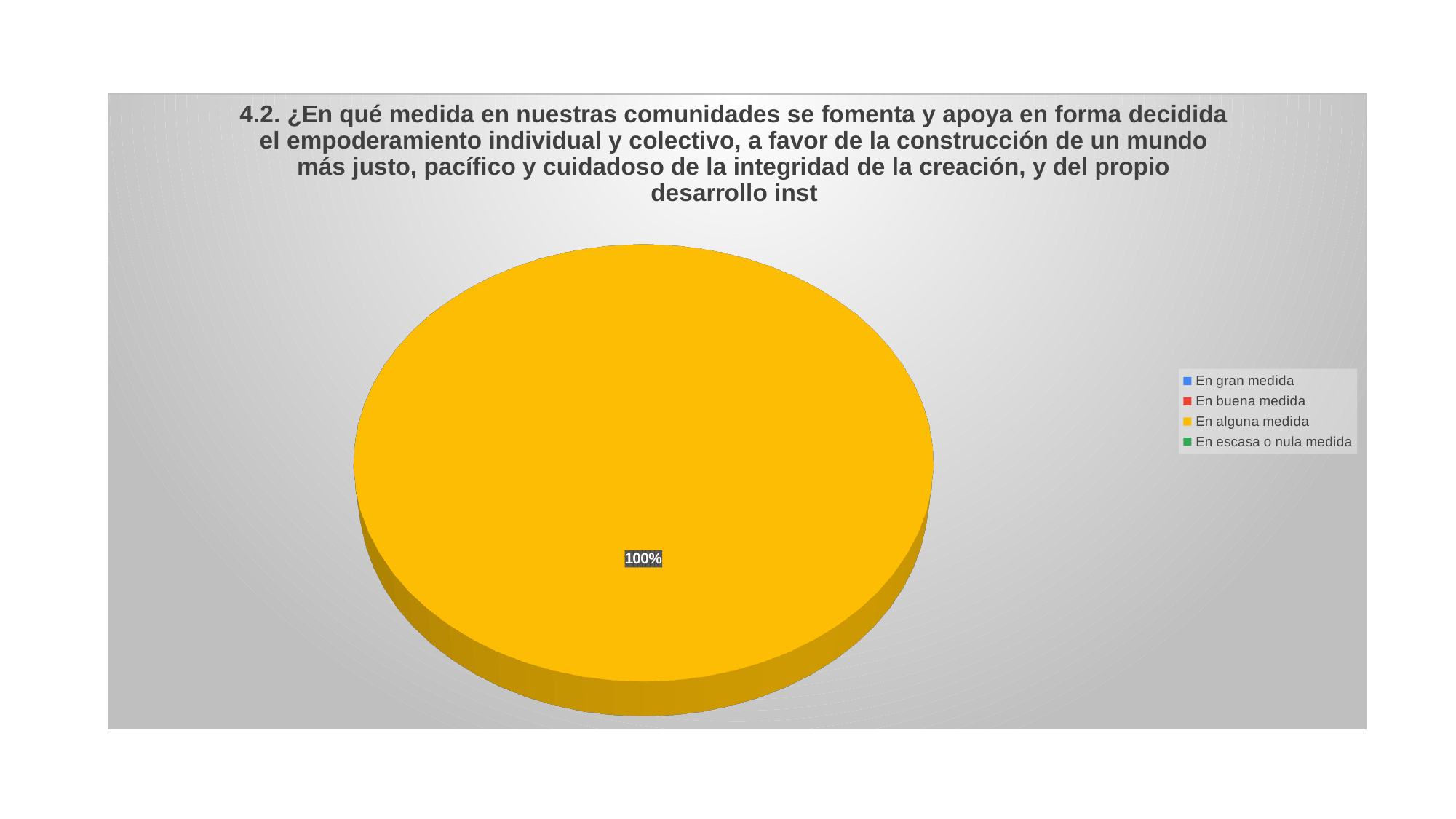
Which legend entry is shown in green? En escasa o nula medida Is the share for "En alguna medida" greater or less than 50%? greater What is the data label printed on the pie slice? 100% Which category makes up the entire pie? En alguna medida Which legend entry is shown in yellow? En alguna medida What share of the pie does "En alguna medida" hold? 100% What kind of chart is shown on the slide? Pie chart How many entries does the legend list? 4 How many slices are visible in the pie? 1